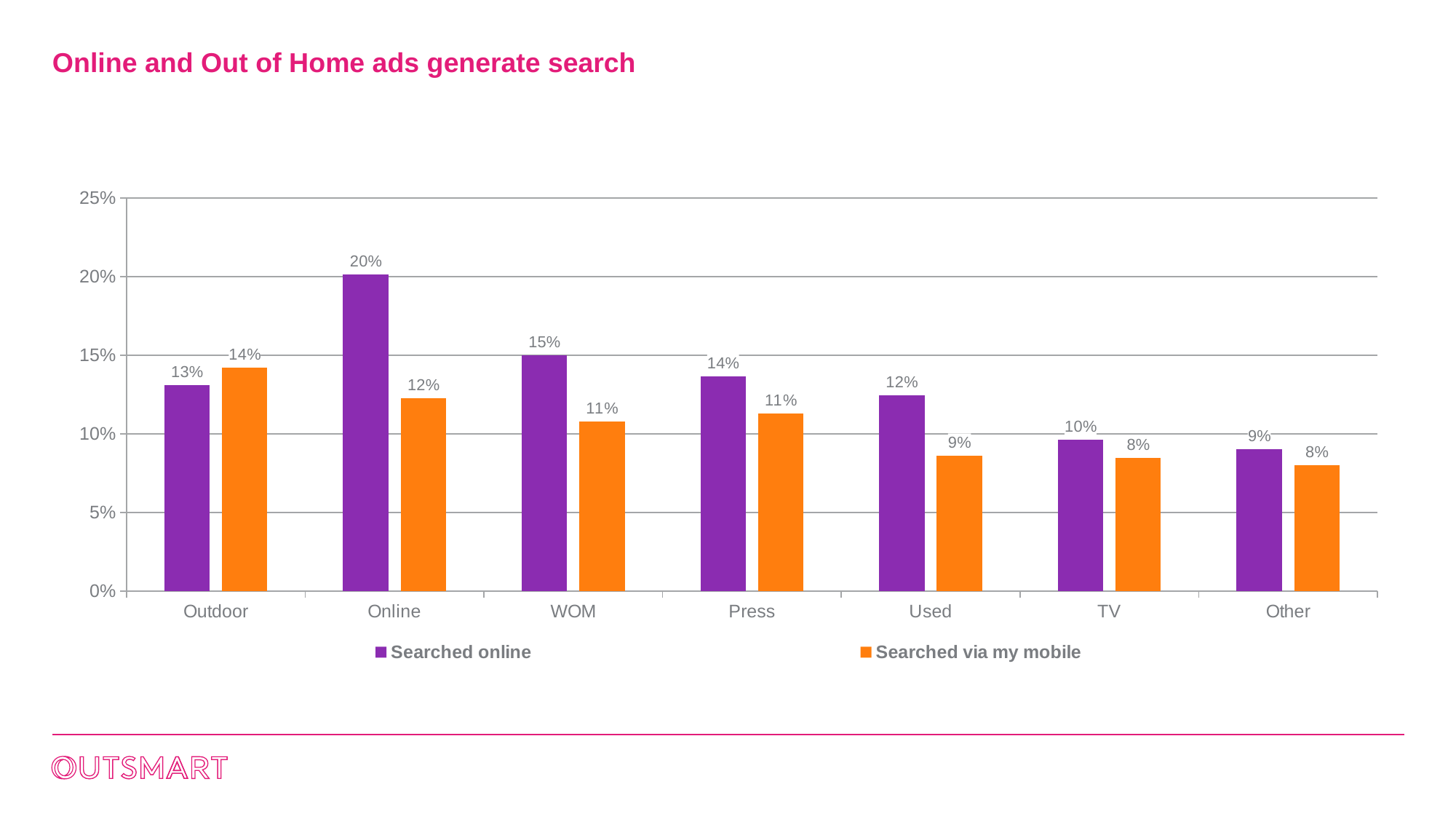
Is the 'Searched online' value for Online greater or less than 15%? greater What is the 'Searched via my mobile' value for Outdoor? 14% What is the difference between the 'Searched online' and 'Searched via my mobile' values for Online? 8% What is the 'Searched online' value for Online? 20% Which category has the highest 'Searched online' value? Online For Outdoor, which is larger: 'Searched online' or 'Searched via my mobile'? Searched via my mobile How many categories are shown on the x axis? 7 What is the 'Searched online' value for WOM? 15% What kind of chart is shown on the slide? Bar chart How many series does the legend list? 2 What is the title of the slide? Online and Out of Home ads generate search